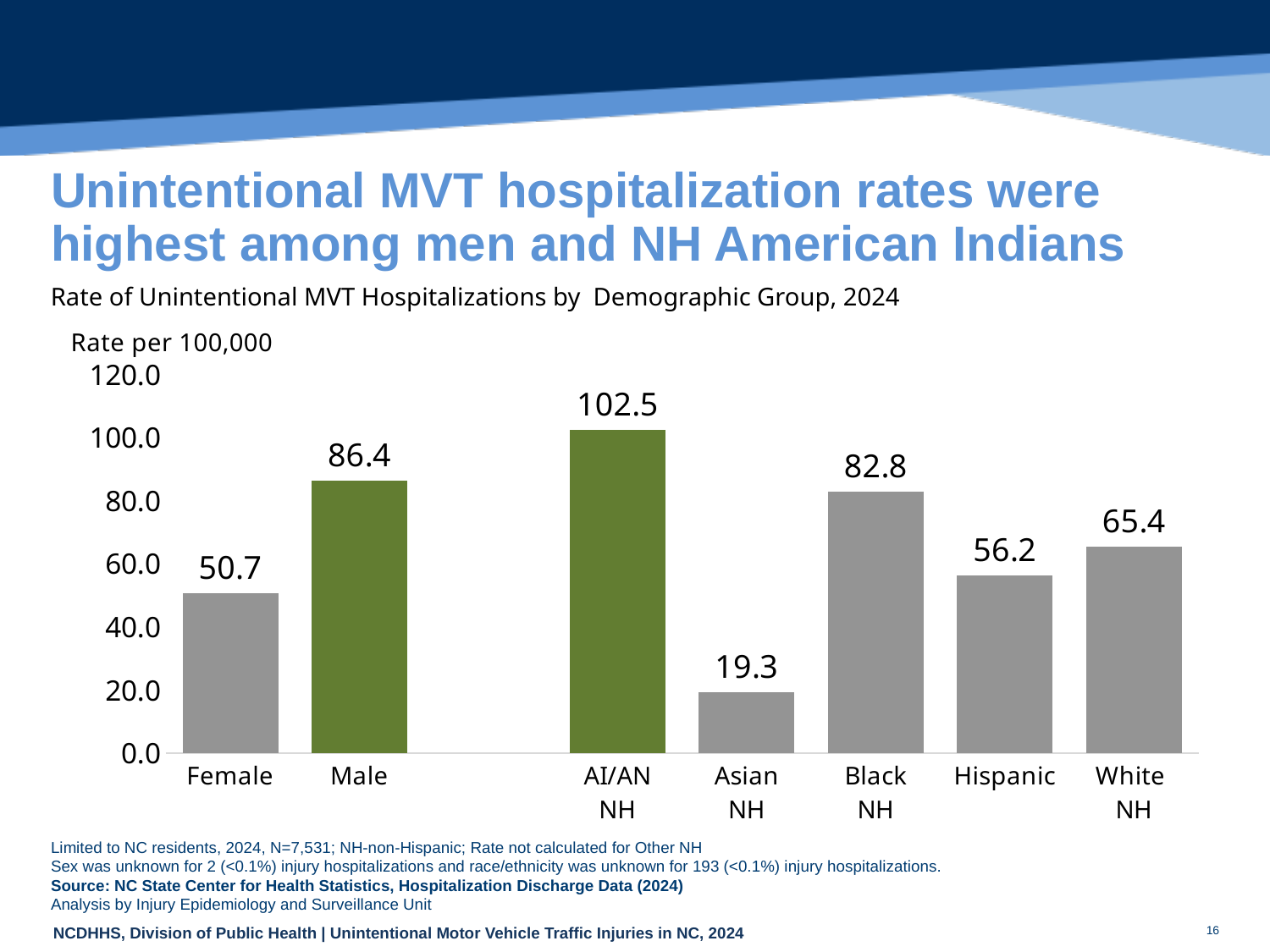
Which demographic group has the lowest rate of unintentional MVT hospitalizations? Asian NH How many demographic groups are shown in the chart? 7 Which has a higher hospitalization rate, Hispanic or White NH? White NH What unit is the y axis of the chart labelled with? Rate per 100,000 What is the difference between the Black NH and White NH hospitalization rates? 17.4 What is the rate of unintentional MVT hospitalizations for Asian NH? 19.3 What kind of chart is shown on the slide? Bar chart Is the hospitalization rate for Black NH greater or less than 80.0? greater What is the rate of unintentional MVT hospitalizations for Male? 86.4 What is the difference between the Male and Female hospitalization rates? 35.7 Which demographic group has the highest rate of unintentional MVT hospitalizations? AI/AN NH What is the rate of unintentional MVT hospitalizations for Hispanic? 56.2